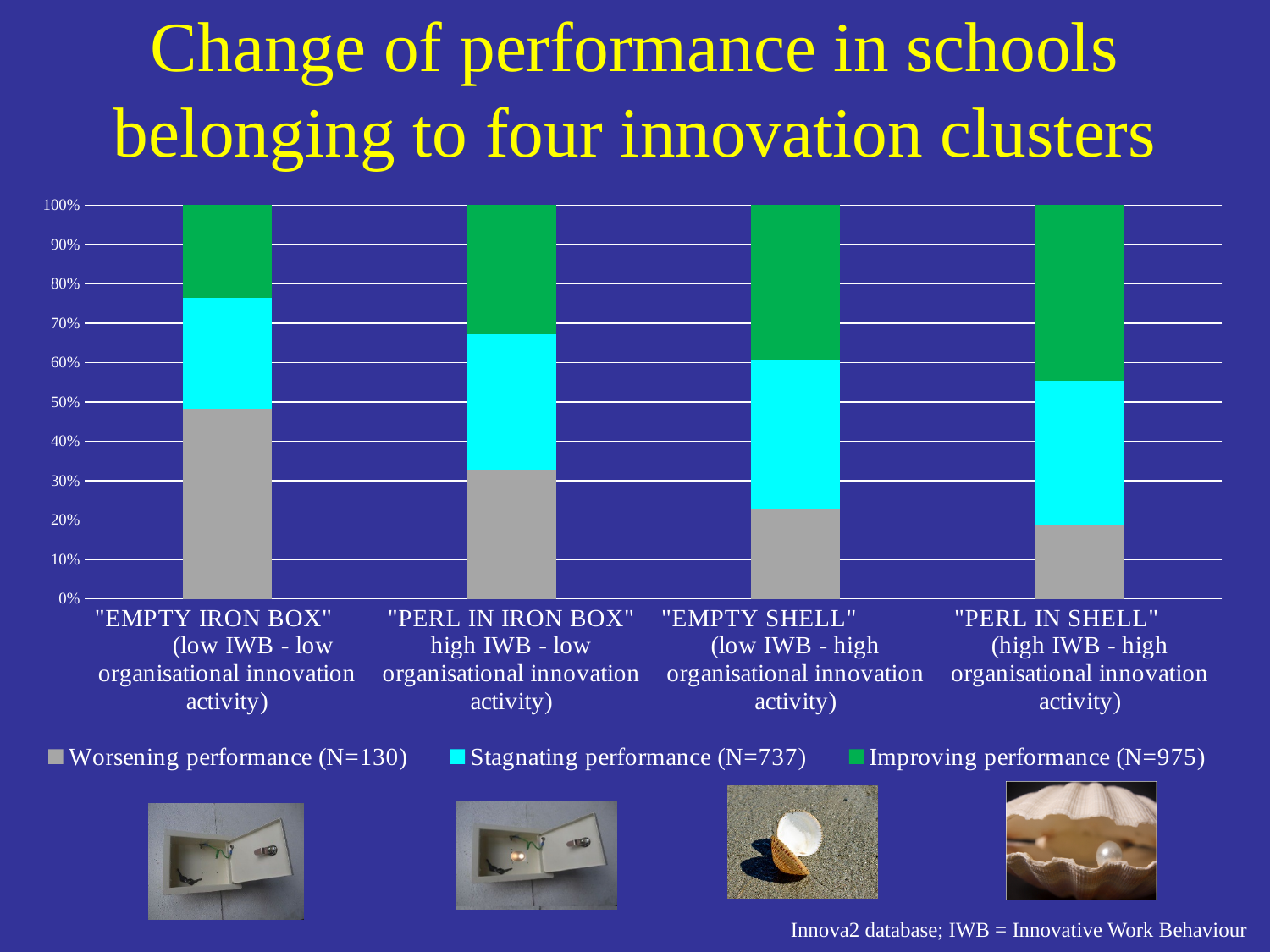
Which has a larger share of worsening performance, "EMPTY IRON BOX" or "PERL IN IRON BOX"? "EMPTY IRON BOX" How many innovation clusters (categories) are shown on the x axis? 4 Which cluster has the smallest share of schools with worsening performance? "PERL IN SHELL" How many series does the legend list? 3 What kind of chart is shown on the slide? stacked bar chart Is the share of worsening performance for "EMPTY IRON BOX" greater or less than 40%? greater Does the share of worsening performance rise or fall moving from left to right across the clusters? fall Is the share of worsening performance for "PERL IN IRON BOX" greater or less than 40%? less What is the N given in the legend for stagnating performance? N=737 Which cluster has the largest share of schools with improving performance? "PERL IN SHELL" Which cluster has the largest share of schools with worsening performance? "EMPTY IRON BOX" Is the share of worsening performance for "EMPTY SHELL" greater or less than 30%? less